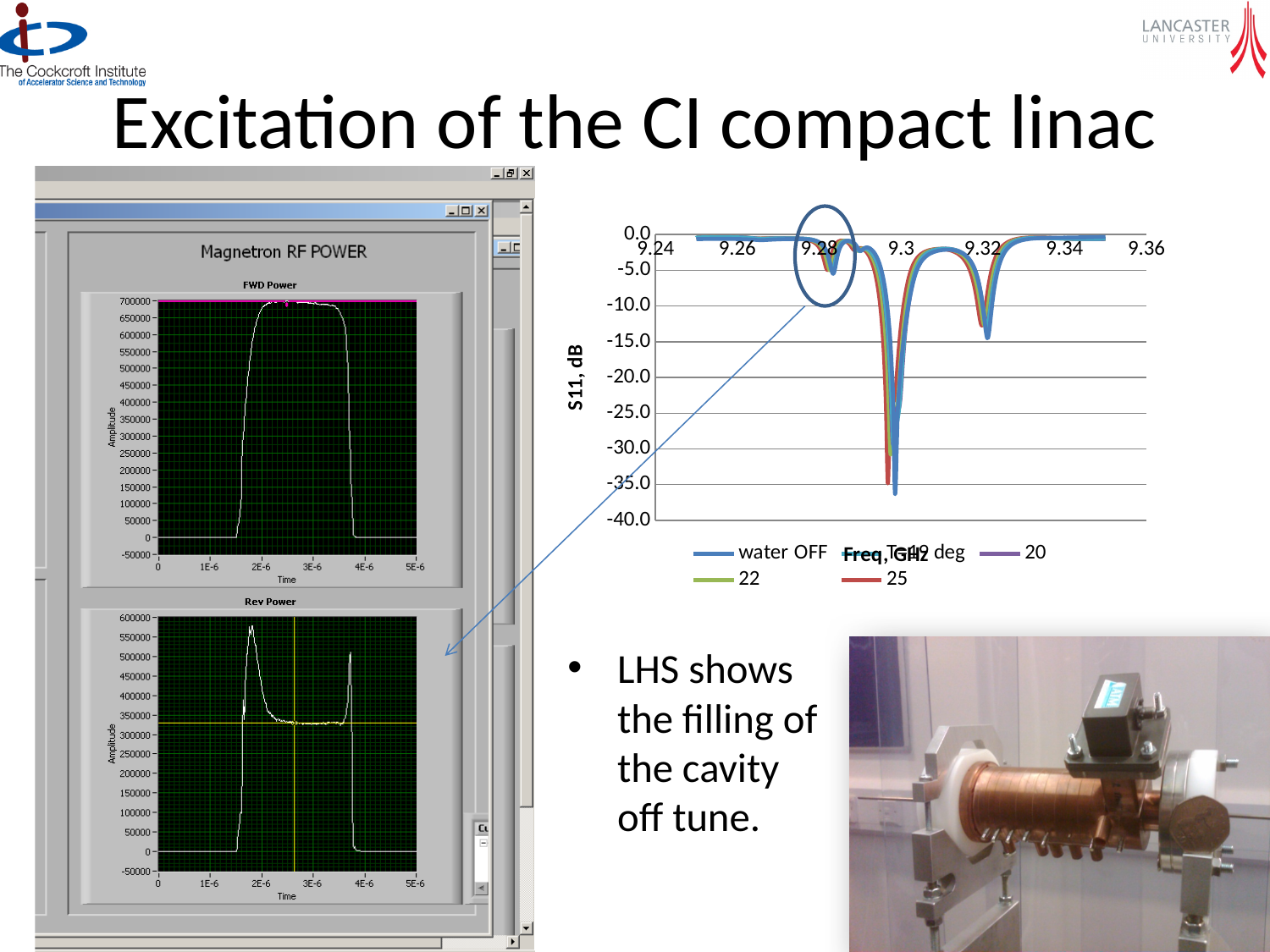
On the S11 chart, which x-axis tick is the deepest dip closest to? 9.3 On the S11 chart, what is the lowest value shown on the y axis? -40.0 What is the label of the y axis on the S11 chart? S11, dB On the S11 chart, what is the highest frequency tick shown on the x axis? 9.36 On the S11 chart, is the dip near 9.3 GHz deeper than the dip near 9.32 GHz? yes What kind of chart is the S11 vs frequency chart on the right of the slide? line chart In the Magnetron RF POWER screenshot on the left, what is the highest amplitude tick on the FWD Power plot's y axis? 700000 On the S11 chart, is the deepest dip of the curves greater or less than -35.0 dB? less What is the label of the x axis on the S11 chart? Freq, GHz On the S11 chart, is the small circled dip near 9.28 GHz greater or less than -10.0 dB? greater On the S11 chart, is the dip near 9.32 GHz greater or less than -10.0 dB? less How many series does the legend of the S11 chart list? 5